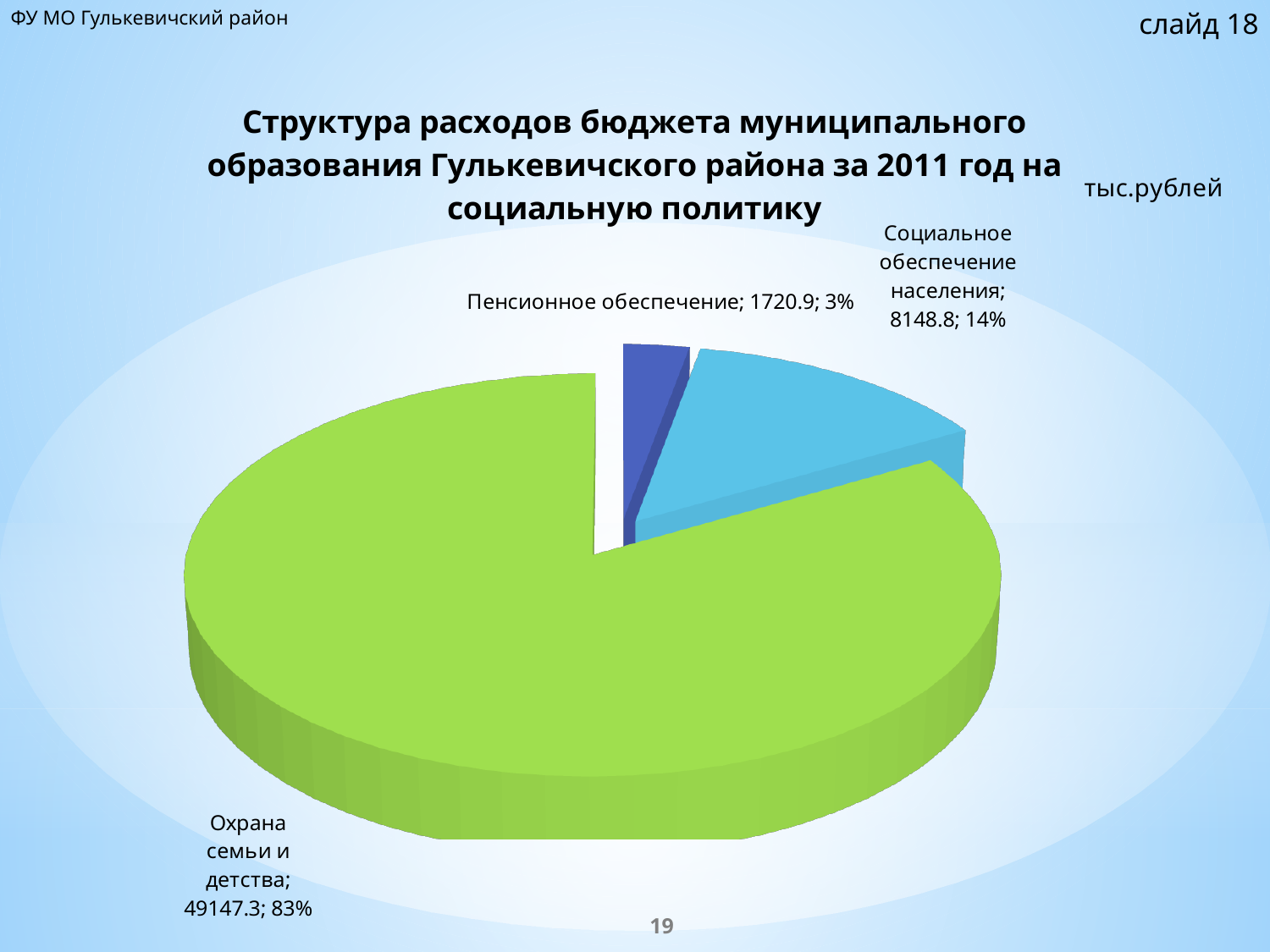
What share of the pie does Социальное обеспечение населения represent? 14% What is the value for Охрана семьи и детства? 49147.3 What kind of chart is shown on the slide? pie chart Which is larger: the value for Социальное обеспечение населения or Пенсионное обеспечение? Социальное обеспечение населения Which category has the smallest slice? Пенсионное обеспечение What is the value for Социальное обеспечение населения? 8148.8 What is the difference between the values for Социальное обеспечение населения and Пенсионное обеспечение? 6427.9 Which category has the largest slice? Охрана семьи и детства What share of the pie does Охрана семьи и детства represent? 83% What is the value for Пенсионное обеспечение? 1720.9 In what units are the values on the chart given? тыс.рублей How many slices does the pie chart have? 3